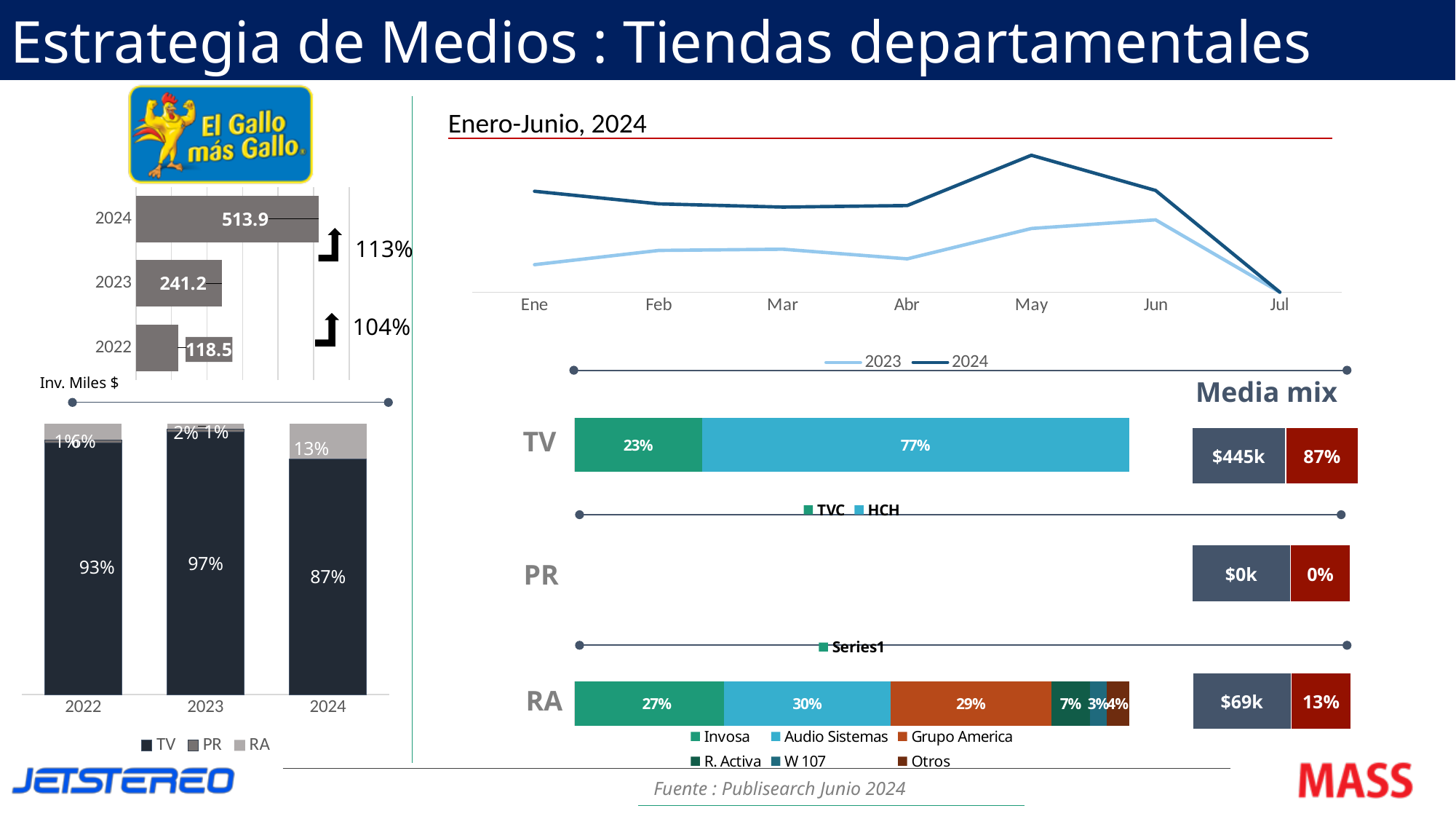
In the RA media mix bar, which station has the largest share? Audio Sistemas In the line chart titled 'Enero-Junio, 2024', in which month does the 2024 line reach its highest point? May In the horizontal bar chart at the top left (Inv. Miles $), which year has the lowest value? 2022 In the Media mix boxes on the right, what is the dollar amount shown for RA? $69k In the line chart titled 'Enero-Junio, 2024', how many months are shown on the x axis? 7 In the TV media mix bar, what share does HCH have? 77% In the horizontal bar chart at the top left (Inv. Miles $), what is the difference between the 2024 and 2023 values? 272.7 In the horizontal bar chart at the top left (Inv. Miles $), what is the value for 2024? 513.9 In the horizontal bar chart at the top left (Inv. Miles $), what is the value for 2022? 118.5 In the stacked bar chart at the bottom left, what share does TV have in 2023? 97% In the stacked bar chart at the bottom left, what share does RA have in 2024? 13% How many series does the legend of the stacked bar chart at the bottom left list? 3